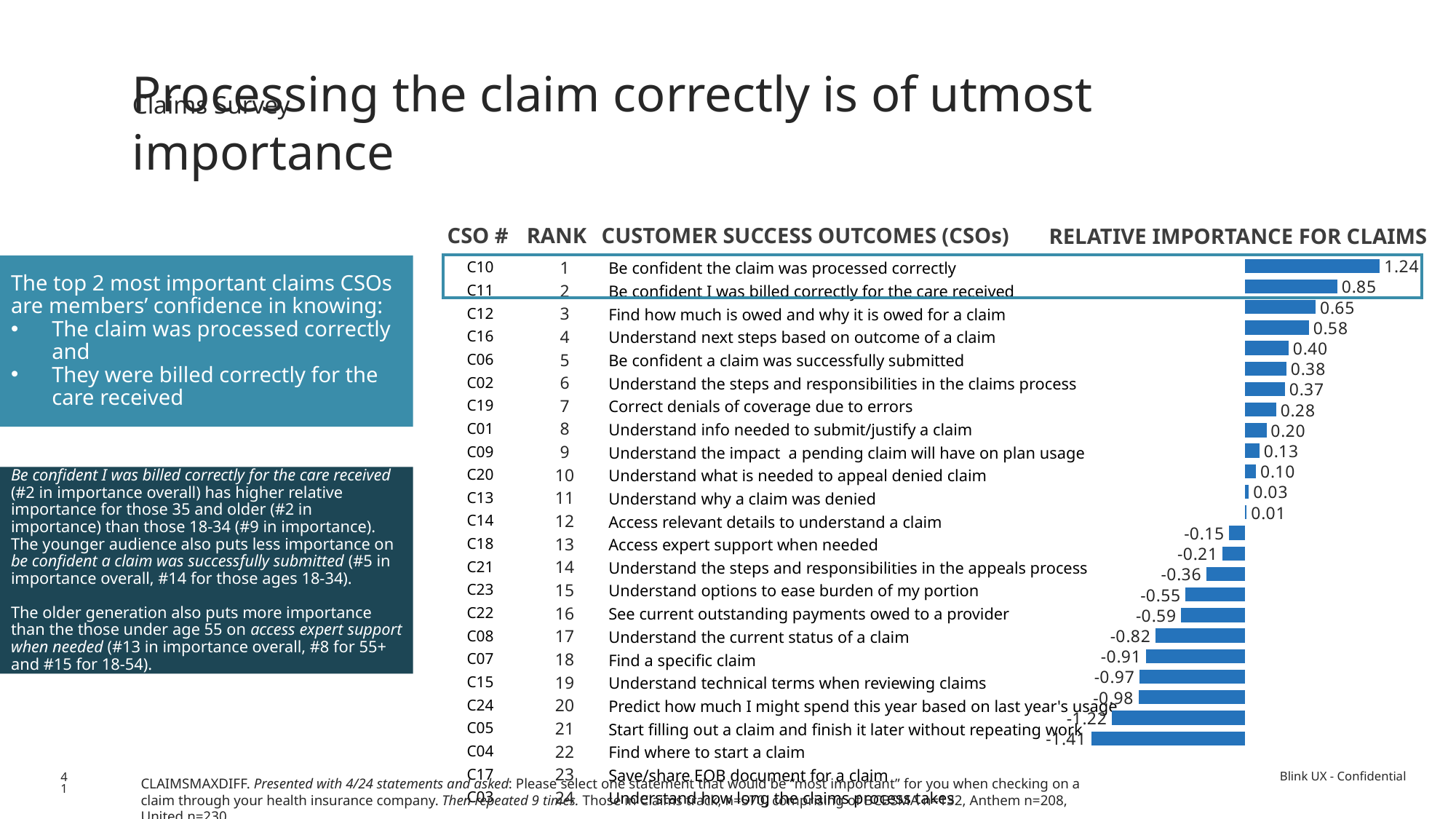
Which customer success outcome has the lowest relative importance for claims? Understand how long the claims process takes What is the difference between the relative importance values of the rank 1 and rank 2 outcomes? 0.39 What is the relative importance value for "Access expert support when needed"? 0.01 What is the relative importance value for "Find a specific claim"? -0.59 What is the relative importance value for "Be confident I was billed correctly for the care received"? 0.85 Which customer success outcome has the highest relative importance for claims? Be confident the claim was processed correctly What type of chart is used to show relative importance for claims? Bar chart What is the title of the column containing the bar chart? RELATIVE IMPORTANCE FOR CLAIMS Which has a higher relative importance: "Understand next steps based on outcome of a claim" or "Be confident a claim was successfully submitted"? Understand next steps based on outcome of a claim Do the relative importance values rise or fall as you move down the ranked list? Fall How many customer success outcomes are plotted in the relative importance chart? 24 What is the relative importance value for "Be confident the claim was processed correctly"? 1.24